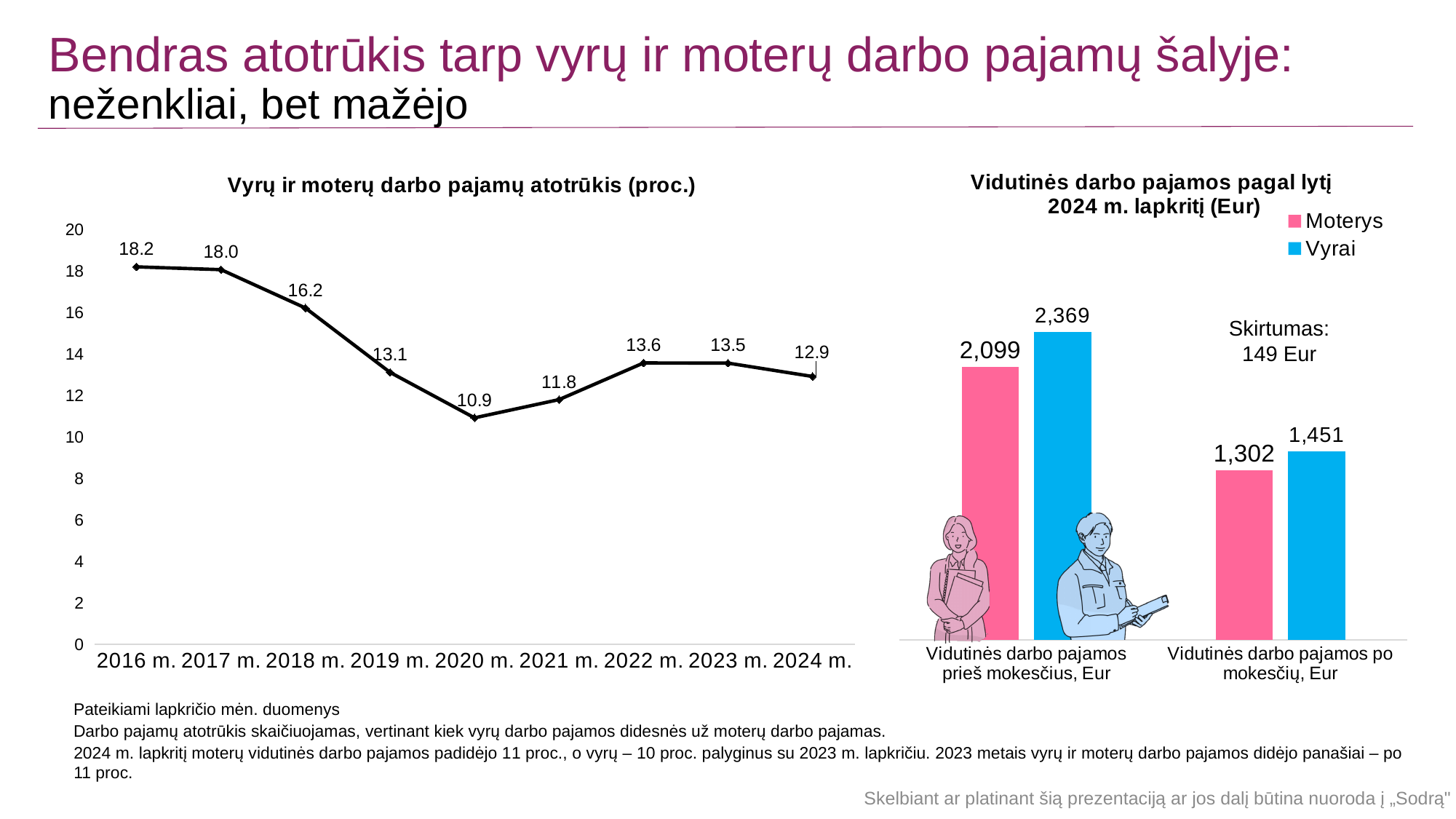
In the chart 'Vidutinės darbo pajamos pagal lytį 2024 m. lapkritį (Eur)', what is the value for Vyrai in 'Vidutinės darbo pajamos prieš mokesčius, Eur'? 2,369 In the chart 'Vyrų ir moterų darbo pajamų atotrūkis (proc.)', what is the difference between the 2016 m. and 2024 m. values? 5.3 In the chart 'Vidutinės darbo pajamos pagal lytį 2024 m. lapkritį (Eur)', what is the difference between Vyrai and Moterys in 'Vidutinės darbo pajamos po mokesčių, Eur'? 149 In the chart 'Vyrų ir moterų darbo pajamų atotrūkis (proc.)', what is the value for 2024 m.? 12.9 In the chart 'Vidutinės darbo pajamos pagal lytį 2024 m. lapkritį (Eur)', which is larger in 'Vidutinės darbo pajamos prieš mokesčius, Eur': Moterys or Vyrai? Vyrai What kind of chart is 'Vyrų ir moterų darbo pajamų atotrūkis (proc.)'? line chart In the chart 'Vyrų ir moterų darbo pajamų atotrūkis (proc.)', what is the value for 2020 m.? 10.9 In the chart 'Vyrų ir moterų darbo pajamų atotrūkis (proc.)', do the values rise or fall from 2016 m. to 2020 m.? fall In the chart 'Vyrų ir moterų darbo pajamų atotrūkis (proc.)', how many years are plotted? 9 In the chart 'Vyrų ir moterų darbo pajamų atotrūkis (proc.)', which year has the lowest value? 2020 m. In the chart 'Vyrų ir moterų darbo pajamų atotrūkis (proc.)', which year has the highest value? 2016 m. How many series does the legend of the chart 'Vidutinės darbo pajamos pagal lytį 2024 m. lapkritį (Eur)' list? 2